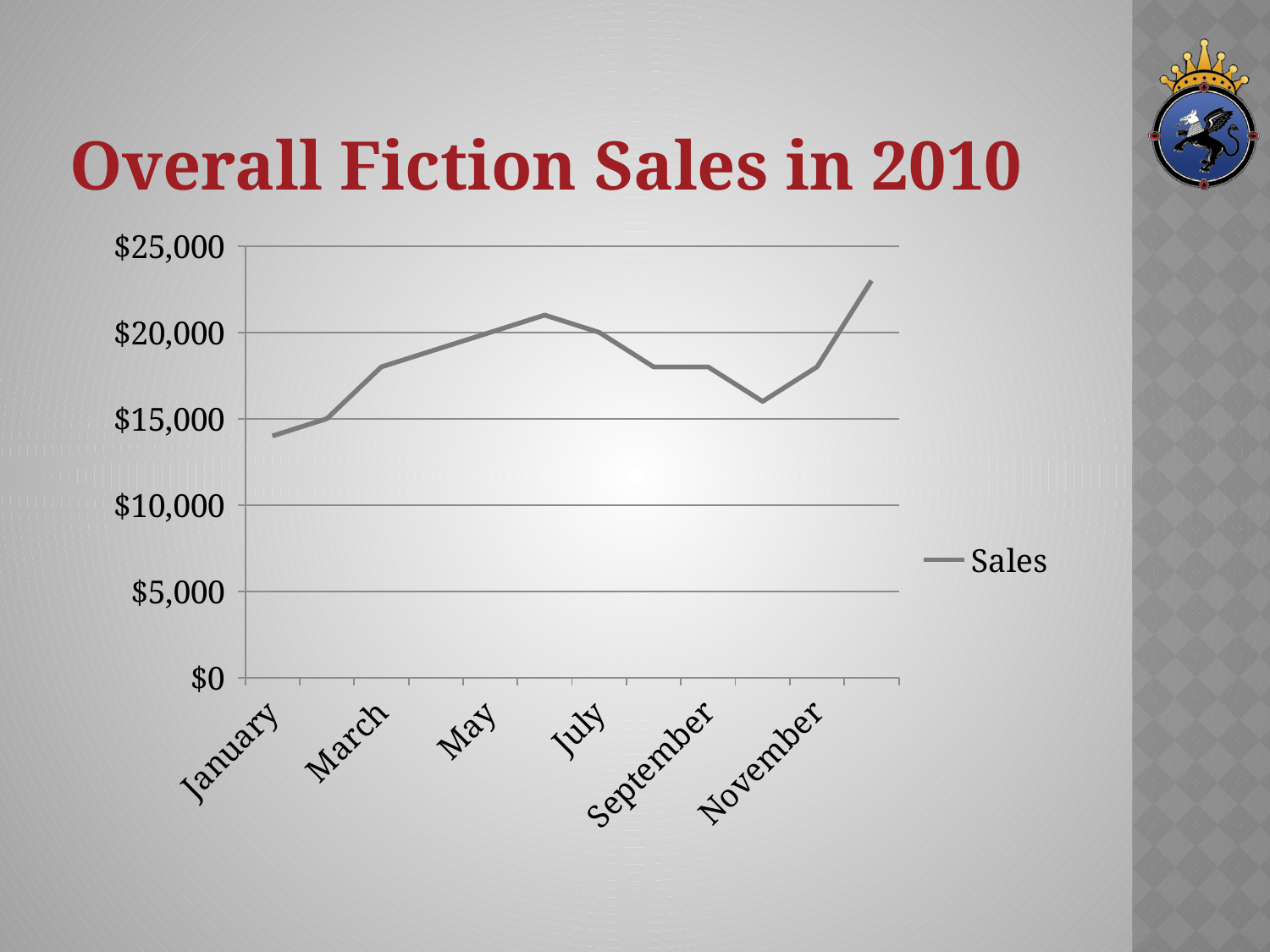
What is the name of the series shown in the legend? Sales Which month has the lowest sales value? January Is the sales value for January greater or less than $15,000? less Which is larger, the sales value for July or the sales value for November? July Do sales rise or fall from January to May? rise What is the title of the chart? Overall Fiction Sales in 2010 Is the sales value for March greater or less than $15,000? greater Is the sales value for December greater or less than $20,000? greater How many series does the legend list? 1 Which month has the highest sales value? December What kind of chart is shown on the slide? Line chart